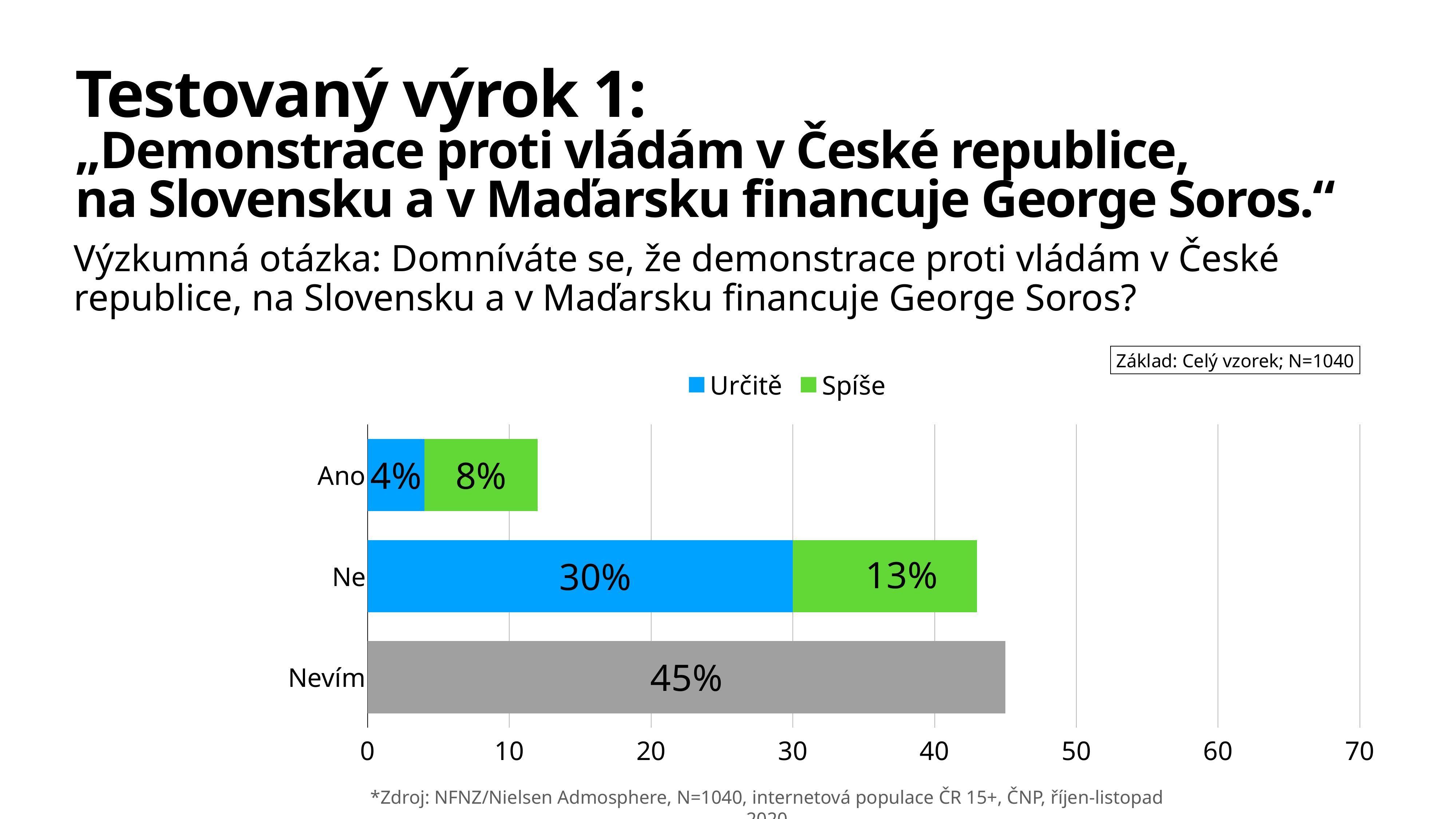
What is the value of the Určitě series for the Ne category? 30% What is the total of the stacked bar for the Ano category? 12% What is the value shown for the Nevím category? 45% What is the value of the Spíše series for the Ano category? 8% Which is larger: the Určitě value for Ne or the Spíše value for Ne? Určitě value for Ne What is the value of the Určitě series for the Ano category? 4% What is the difference between the Spíše values for Ne and Ano? 5% Which category has the longest bar overall? Nevím How many series does the legend list? 2 What kind of chart is shown on the slide? Bar chart How many categories are shown on the y axis? 3 What is the total of the stacked bar for the Ne category? 43%